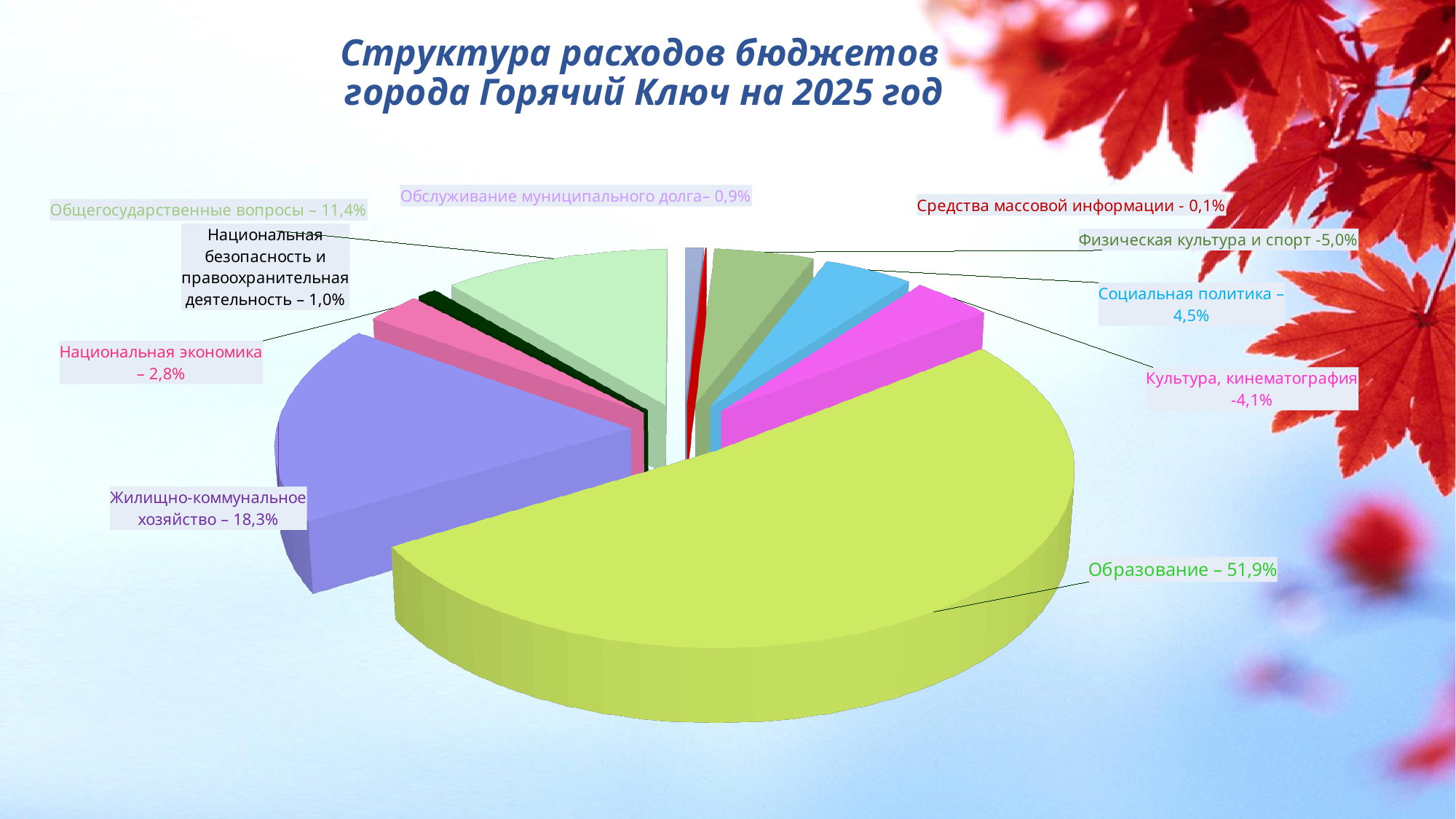
Which category has the largest share of the pie? Образование What share is labelled for Общегосударственные вопросы? 11,4% What is the difference between the shares of Национальная экономика and Национальная безопасность и правоохранительная деятельность? 1,8% What share of the budget expenditures goes to Образование? 51,9% What kind of chart is shown on the slide? Pie chart Which category has the smallest share of the pie? Средства массовой информации What is the difference between the shares of Образование and Жилищно-коммунальное хозяйство? 33,6% Which is larger: the share for Физическая культура и спорт or the share for Культура, кинематография? Физическая культура и спорт What share is labelled for Социальная политика? 4,5% What share is labelled for Жилищно-коммунальное хозяйство? 18,3% What is the title of the chart on the slide? Структура расходов бюджетов города Горячий Ключ на 2025 год How many categories are shown in the pie chart? 10